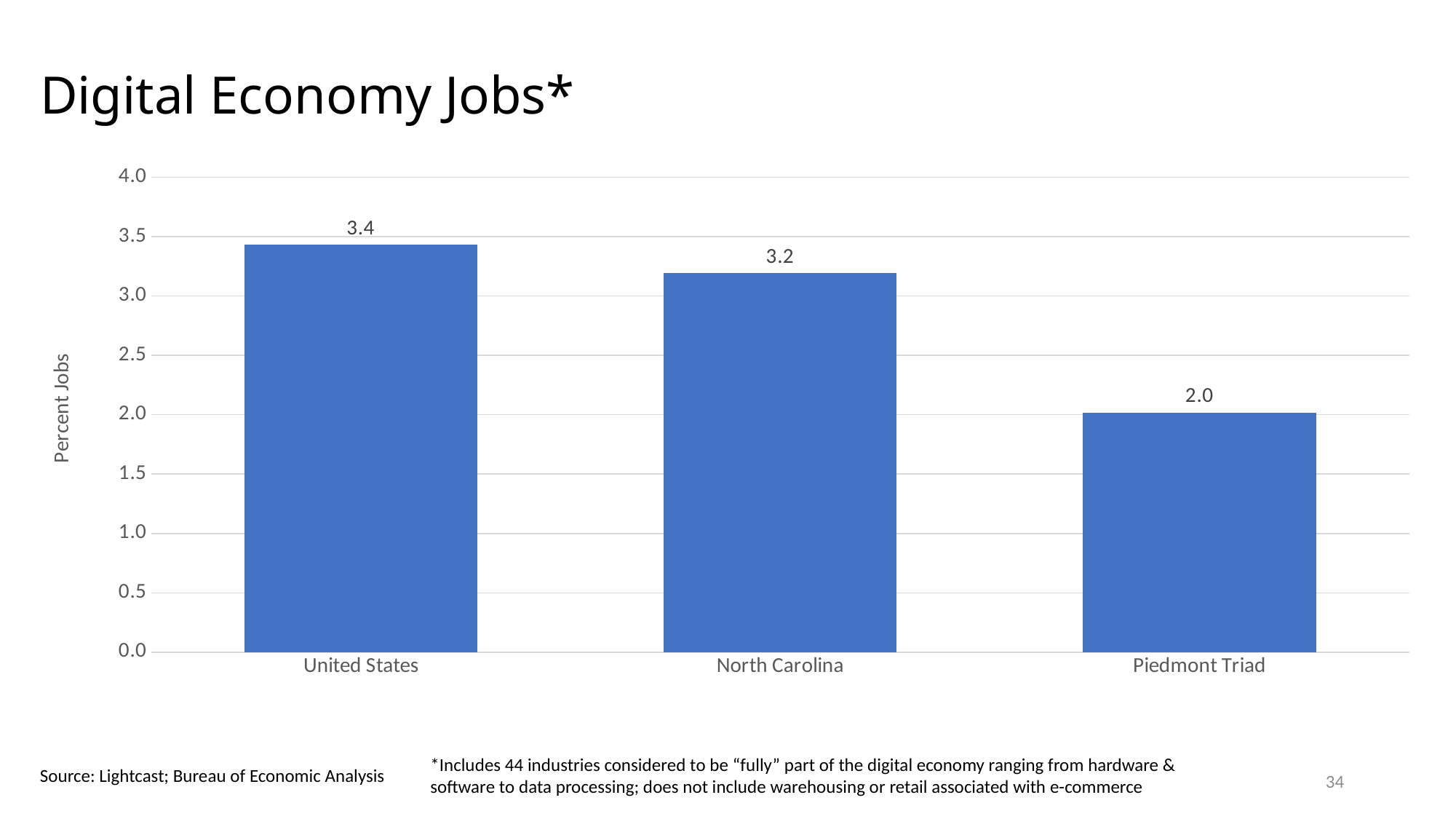
Is the value for North Carolina greater or less than 3.0? greater How many categories are shown in the chart? 3 What is the value for Piedmont Triad? 2.0 What is the value for North Carolina? 3.2 Which category has the lowest value? Piedmont Triad What is the label on the vertical axis of the chart? Percent Jobs What is the difference between the values for North Carolina and Piedmont Triad? 1.2 What is the value for United States? 3.4 What kind of chart is shown on the slide? bar chart Which is larger, the value for North Carolina or the value for Piedmont Triad? North Carolina What is the difference between the values for United States and Piedmont Triad? 1.4 Which category has the highest value? United States